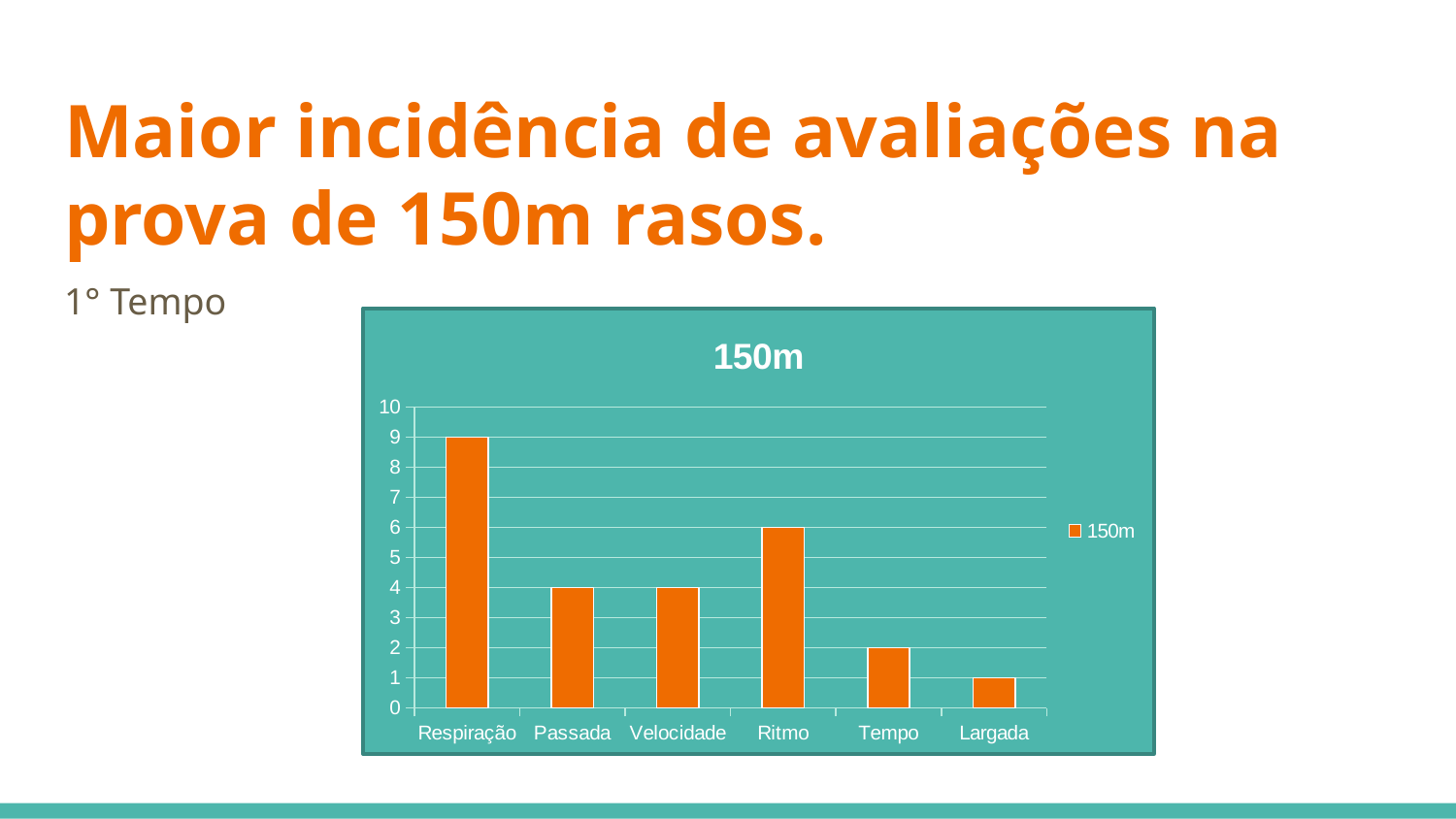
Which category has the lowest value? Largada What is the difference between the values for Respiração and Ritmo? 3 Which category has the highest value? Respiração What is the value for Respiração? 9 Which is larger, the value for Ritmo or the value for Tempo? Ritmo How many series does the legend list? 1 How many categories are shown on the x axis of the chart? 6 Is the value for Passada greater or less than 5? less What is the title of the chart? 150m What kind of chart is shown on the slide? bar chart What is the value for Largada? 1 What is the value for Ritmo? 6